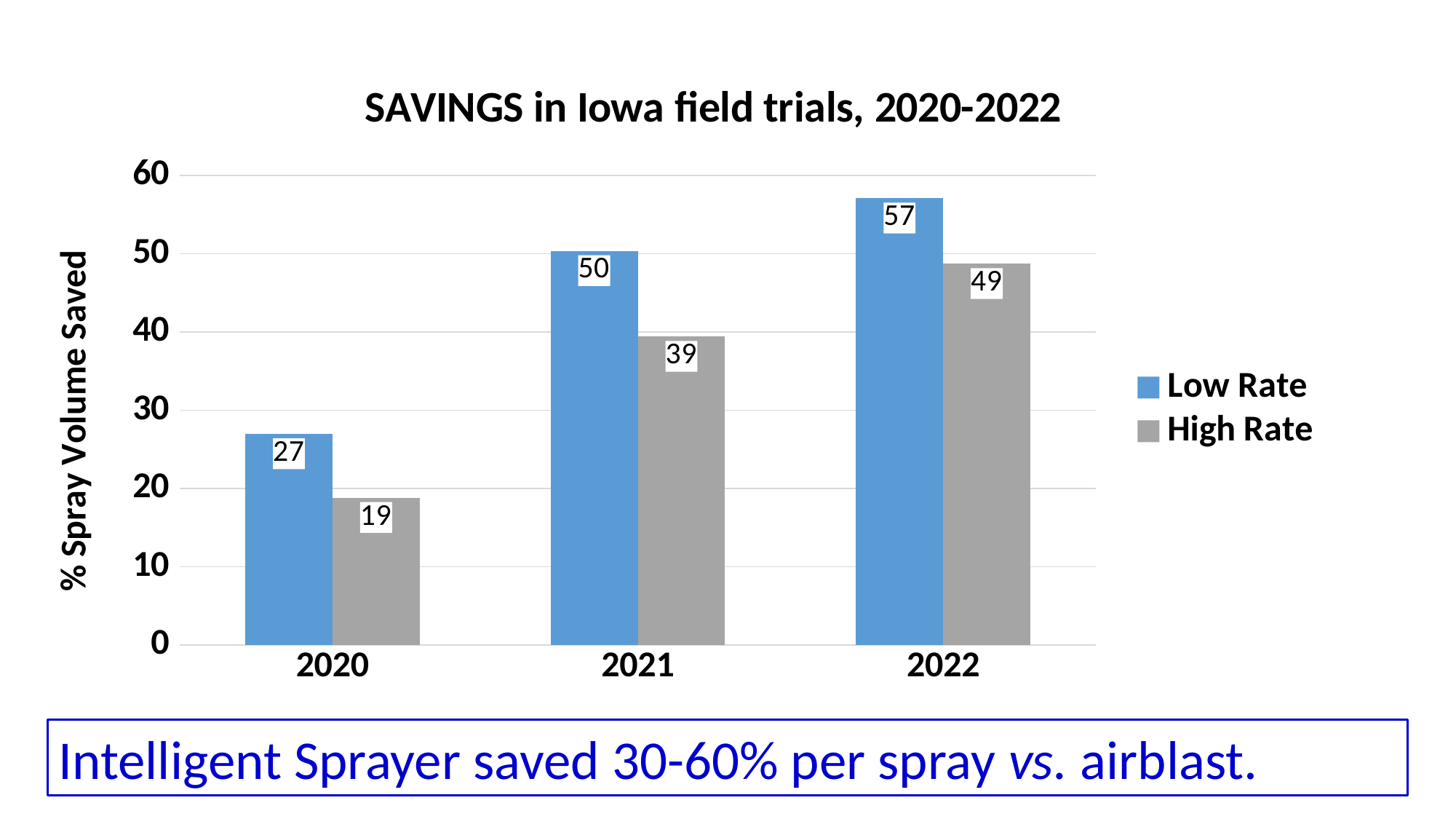
How many series does the legend list? 2 Is the High Rate value for 2021 greater or less than 30? greater What is the difference between the Low Rate and High Rate values in 2021? 11 What is the High Rate value for 2022? 49 Do the Low Rate values rise or fall from 2020 to 2022? Rise What kind of chart is shown? Bar chart What is the High Rate value for 2020? 19 What is the Low Rate value for 2021? 50 Which year has the lowest High Rate value? 2020 How many years are shown on the x axis? 3 Which year has the highest Low Rate value? 2022 Which is larger in 2020, the Low Rate value or the High Rate value? Low Rate